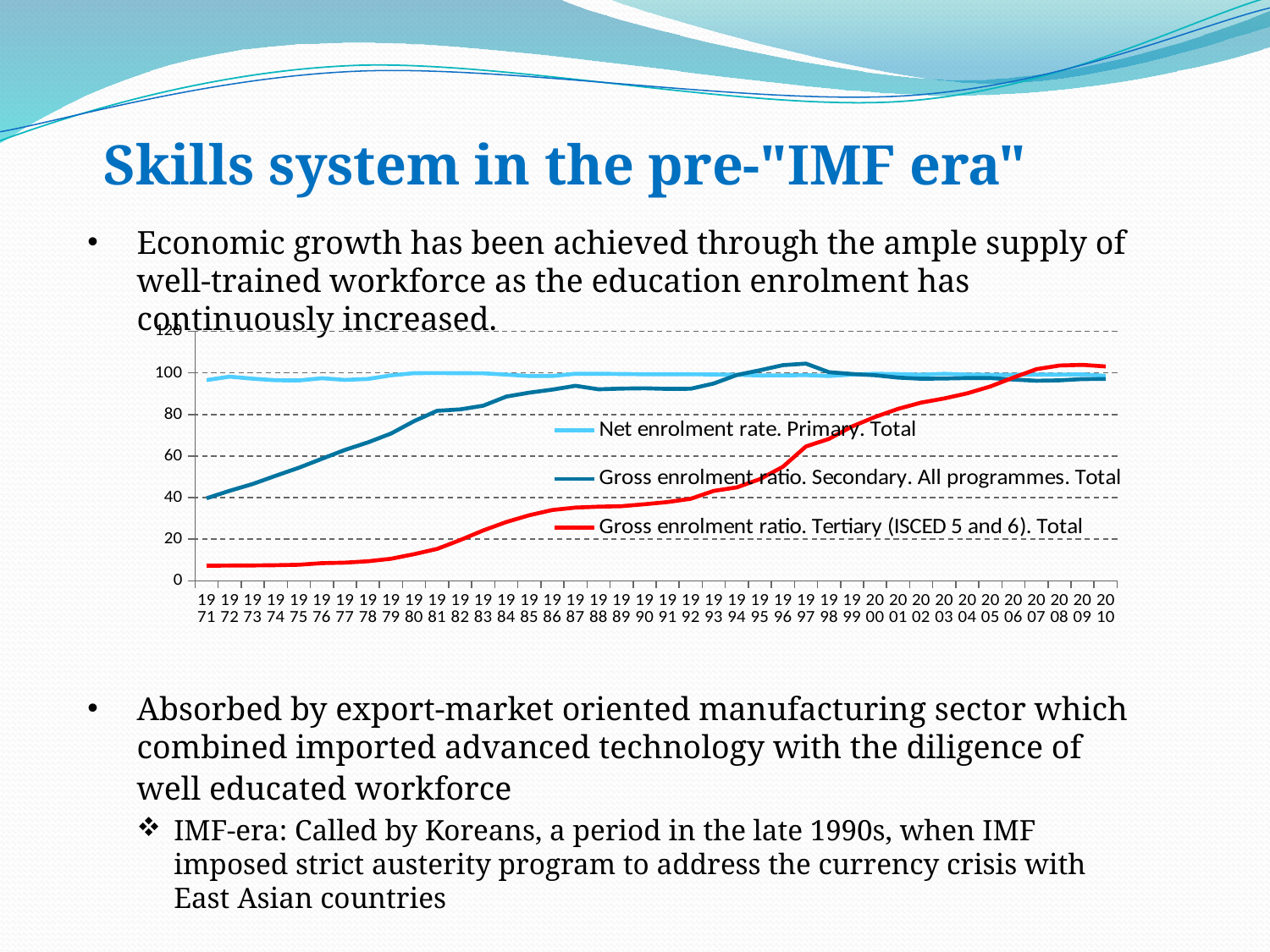
Does the Gross enrolment ratio. Tertiary (ISCED 5 and 6). Total series rise or fall from 1971 to 2010? rise Which series is shown in red on the chart? Gross enrolment ratio. Tertiary (ISCED 5 and 6). Total In 1980, which is larger: Gross enrolment ratio. Secondary. All programmes. Total or Gross enrolment ratio. Tertiary (ISCED 5 and 6). Total? Gross enrolment ratio. Secondary. All programmes. Total How many series does the chart legend list? 3 Is the value for Gross enrolment ratio. Tertiary (ISCED 5 and 6). Total in 1971 greater or less than 20? less How many years are plotted along the x axis of the chart? 40 Is the value for Gross enrolment ratio. Tertiary (ISCED 5 and 6). Total in 2000 greater or less than 60? greater What is the first year shown on the x axis of the chart? 1971 Is the value for Gross enrolment ratio. Secondary. All programmes. Total in 1971 greater or less than 60? less Which series has the lowest value in 1971? Gross enrolment ratio. Tertiary (ISCED 5 and 6). Total What kind of chart is shown on the slide? line chart